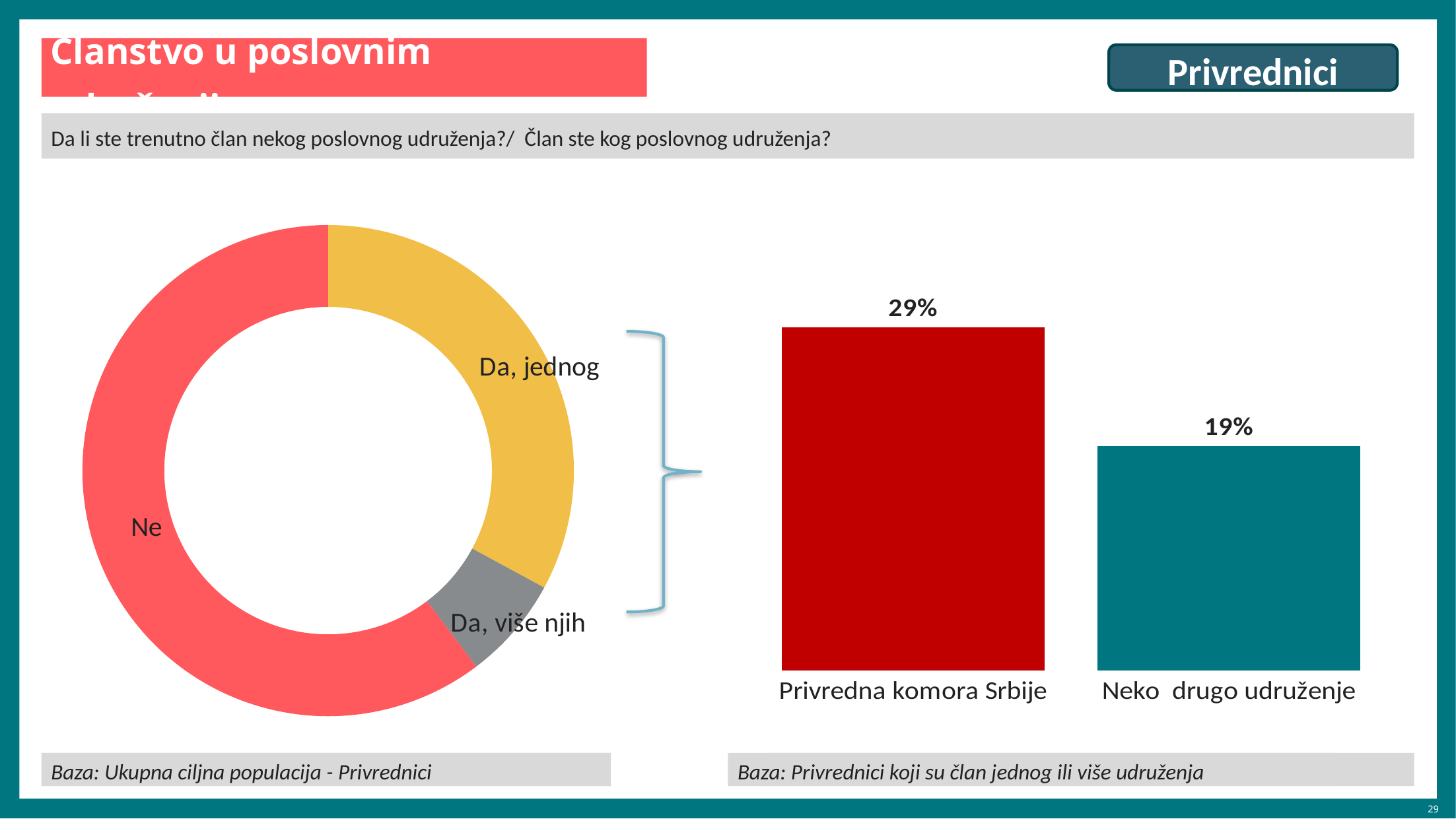
What kind of chart is shown on the right side of the slide? Bar chart In the bar chart on the right, what is the value for Privredna komora Srbije? 29% In the bar chart on the right, which category has the highest value? Privredna komora Srbije How many categories are shown in the donut chart on the left? 3 In the bar chart on the right, which category has the lowest value? Neko drugo udruženje In the bar chart on the right, which is larger: the value for Privredna komora Srbije or for Neko drugo udruženje? Privredna komora Srbije In the bar chart on the right, what is the difference between the values for Privredna komora Srbije and Neko drugo udruženje? 10% In the donut chart on the left, which category has the largest slice? Ne In the bar chart on the right, what is the value for Neko drugo udruženje? 19% How many bars are in the bar chart on the right? 2 What kind of chart is shown on the left side of the slide? Donut chart In the donut chart on the left, which category has the smallest slice? Da, više njih